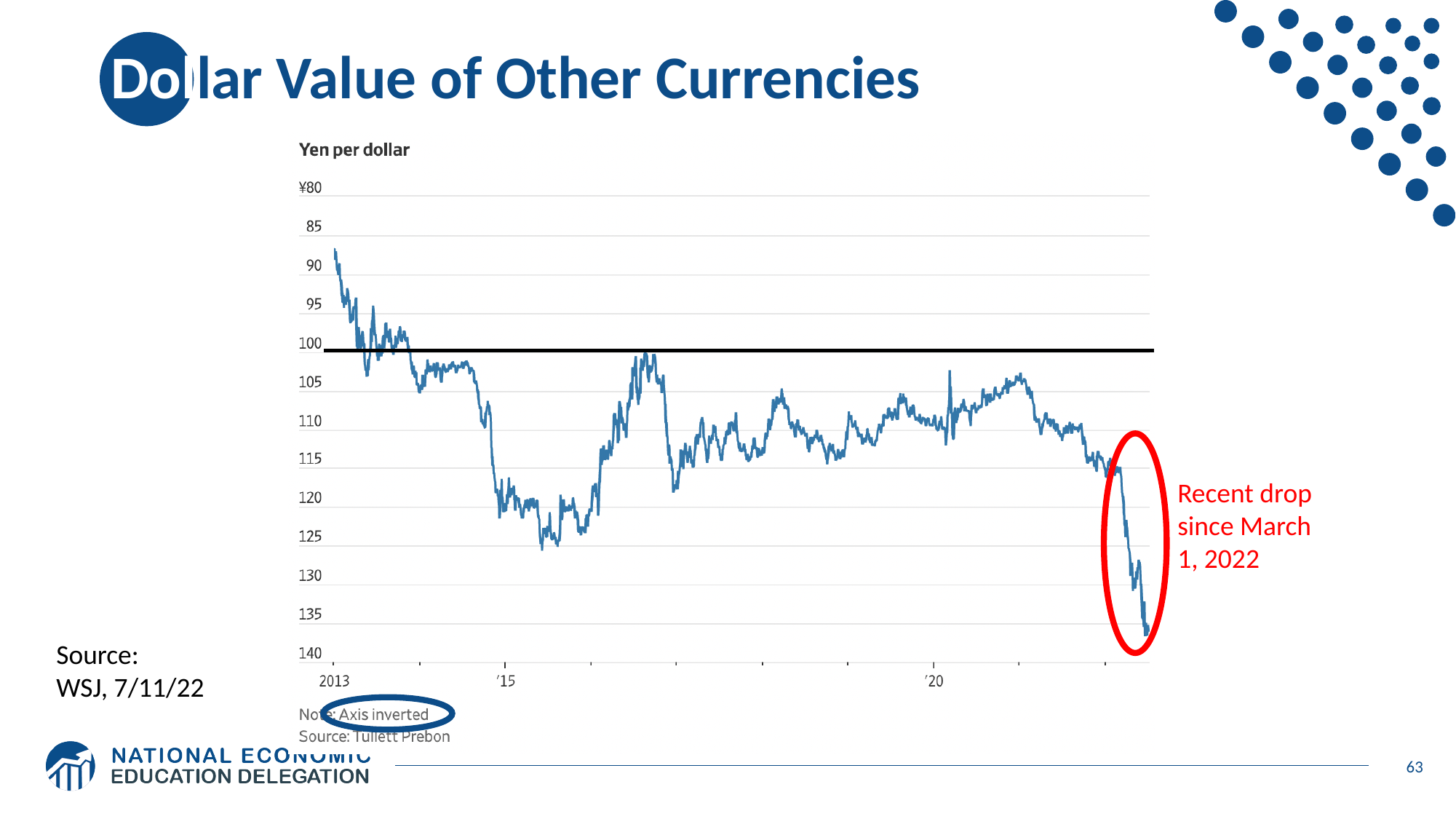
Which is larger, the yen-per-dollar value at the start of 2013 or the value in 2015? 2015 What does the note below the chart say about the axis? Axis inverted In which year does the plotted yen-per-dollar value reach its lowest point? 2013 Is the peak yen-per-dollar value reached around 2015–2016 greater or less than 120? greater How many lines (series) are plotted on the chart? 1 From March 1, 2022 to the end of the series, does the plotted yen-per-dollar value rise or fall? rise Is the yen-per-dollar value at the start of the series in 2013 greater or less than 95? less What is the title printed above the chart's y axis? Yen per dollar What kind of chart is shown on the slide? Line chart In which year does the plotted yen-per-dollar value reach its highest point? 2022 Which is larger, the yen-per-dollar value at the start of the series in 2013 or at the end of the series in 2022? End of the series in 2022 Is the yen-per-dollar value at the end of the series (mid-2022) greater or less than 130? greater